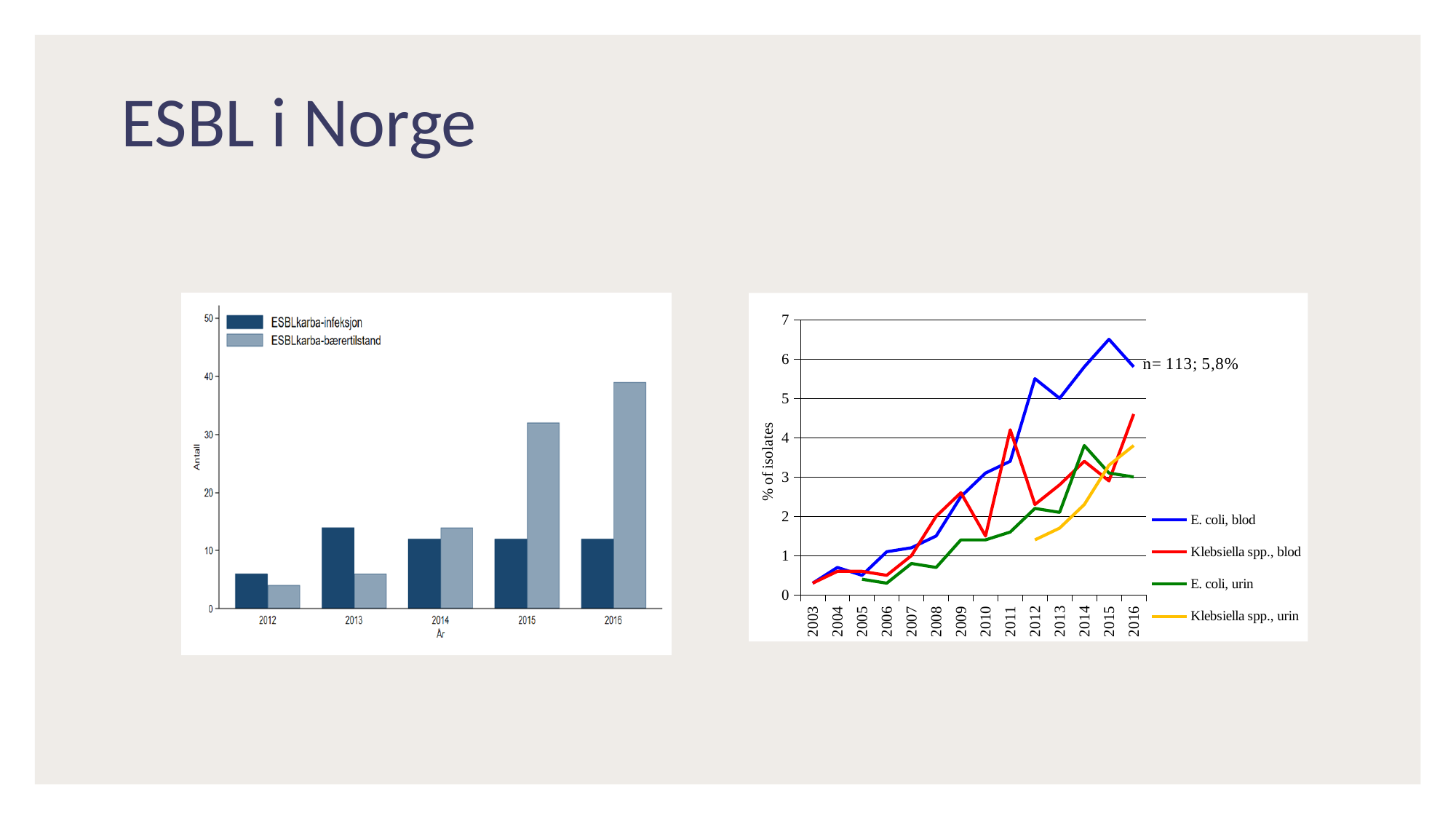
In the left bar chart, is the value for ESBLkarba-infeksjon in 2012 greater or less than 10? less In the right line chart, is the value for E. coli, blod in 2015 greater or less than 6? greater What kind of chart is the right chart on the slide? line chart In the left bar chart, which year has the lowest value for ESBLkarba-bærertilstand? 2012 What kind of chart is the left chart on the slide? bar chart In the left bar chart, which year has the highest value for ESBLkarba-bærertilstand? 2016 In the left bar chart, in 2015, which is larger: ESBLkarba-infeksjon or ESBLkarba-bærertilstand? ESBLkarba-bærertilstand In the left bar chart, is the value for ESBLkarba-bærertilstand in 2016 greater or less than 30? greater In the right line chart, how many series does the legend list? 4 In the left bar chart, how many years are shown on the x axis? 5 In the left bar chart, how many series does the legend list? 2 In the right line chart, what annotation is printed next to the end of the E. coli, blod line? n= 113; 5,8%